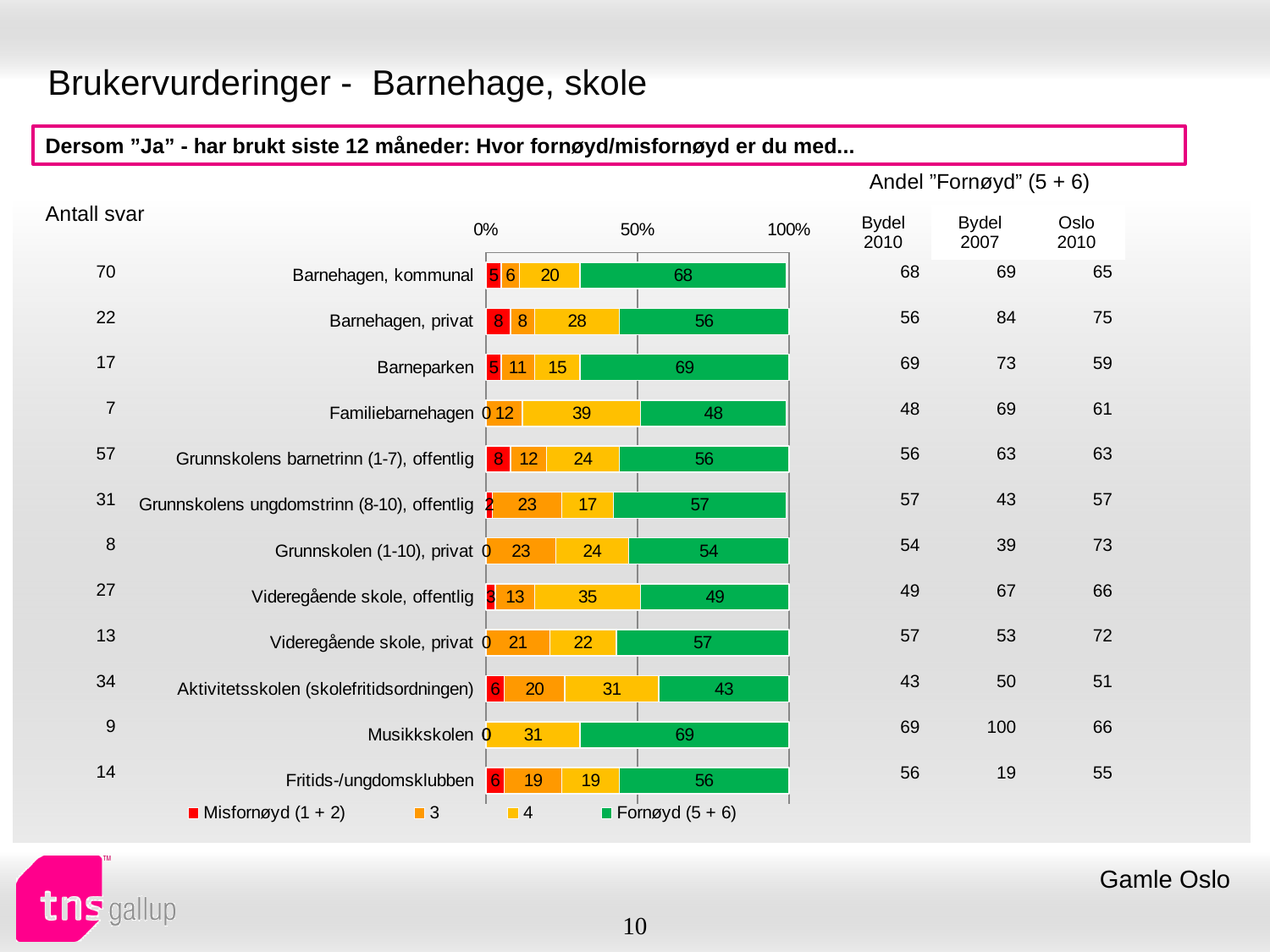
What is the Misfornøyd (1 + 2) value for Barnehagen, privat? 8 How many series does the chart legend list? 4 What is the Fornøyd (5 + 6) value for Barnehagen, kommunal? 68 What is the difference between the Fornøyd (5 + 6) values for Barneparken and Familiebarnehagen? 21 Which category has the highest value for series 4? Familiebarnehagen What kind of chart is shown on the slide? Stacked bar chart How many categories are plotted in the chart? 12 What is the value of series 4 for Familiebarnehagen? 39 Which category has the lowest Fornøyd (5 + 6) value? Aktivitetsskolen (skolefritidsordningen) Which has a larger Fornøyd (5 + 6) value, Barnehagen, kommunal or Videregående skole, offentlig? Barnehagen, kommunal What is the label of the first (red) series in the legend? Misfornøyd (1 + 2) What is the value of series 3 for Aktivitetsskolen (skolefritidsordningen)? 20